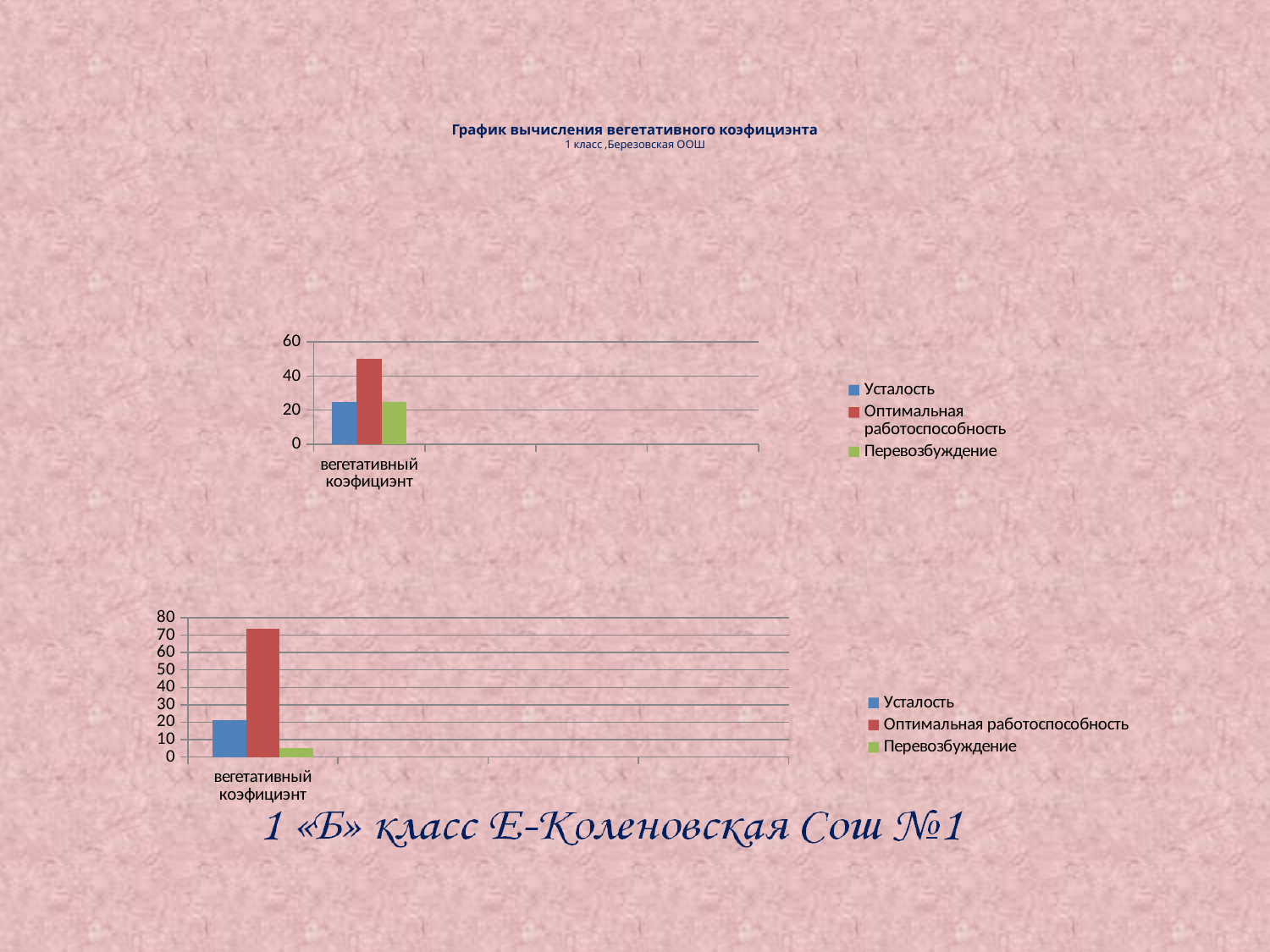
How many series does the legend of the top chart list? 3 In the top chart, which series has the highest bar? Оптимальная работоспособность In the bottom chart, is the value for Усталость greater or less than 30? less In the top chart, is the value for Оптимальная работоспособность greater or less than 40? greater In the top chart, which is larger: Оптимальная работоспособность or Усталость? Оптимальная работоспособность In the bottom chart, which is larger: Усталость or Перевозбуждение? Усталость What kind of chart is the top chart on the slide? bar chart What is the title of the top chart? График вычисления вегетативного коэфициэнта In the bottom chart, is the value for Перевозбуждение greater or less than 10? less In the bottom chart, which series has the lowest bar? Перевозбуждение In the bottom chart, which series has the highest bar? Оптимальная работоспособность